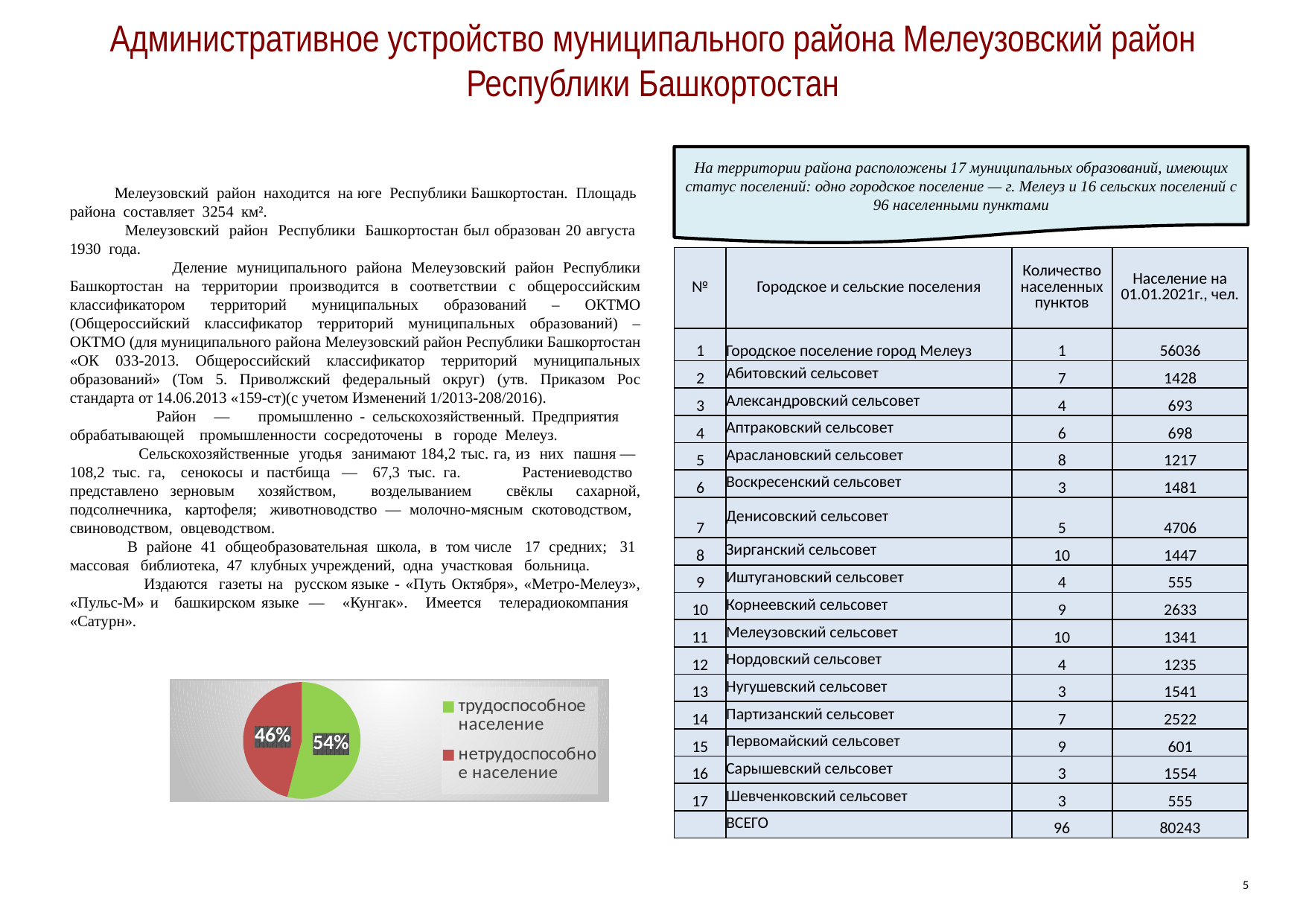
How many slices does the pie chart have? 2 Is the share of "нетрудоспособное население" in the pie chart greater or less than 50%? less What colour is the "нетрудоспособное население" slice in the pie chart? red What share of the pie chart is labelled "нетрудоспособное население"? 46% Which is larger in the pie chart: "трудоспособное население" or "нетрудоспособное население"? трудоспособное население What is the difference in percentage points between the "трудоспособное население" and "нетрудоспособное население" slices? 8 What kind of chart is shown on the slide? pie chart Which slice of the pie chart is the largest? трудоспособное население What share of the pie chart is labelled "трудоспособное население"? 54% Which slice of the pie chart is the smallest? нетрудоспособное население How many entries does the pie chart legend list? 2 What colour is the "трудоспособное население" slice in the pie chart? green